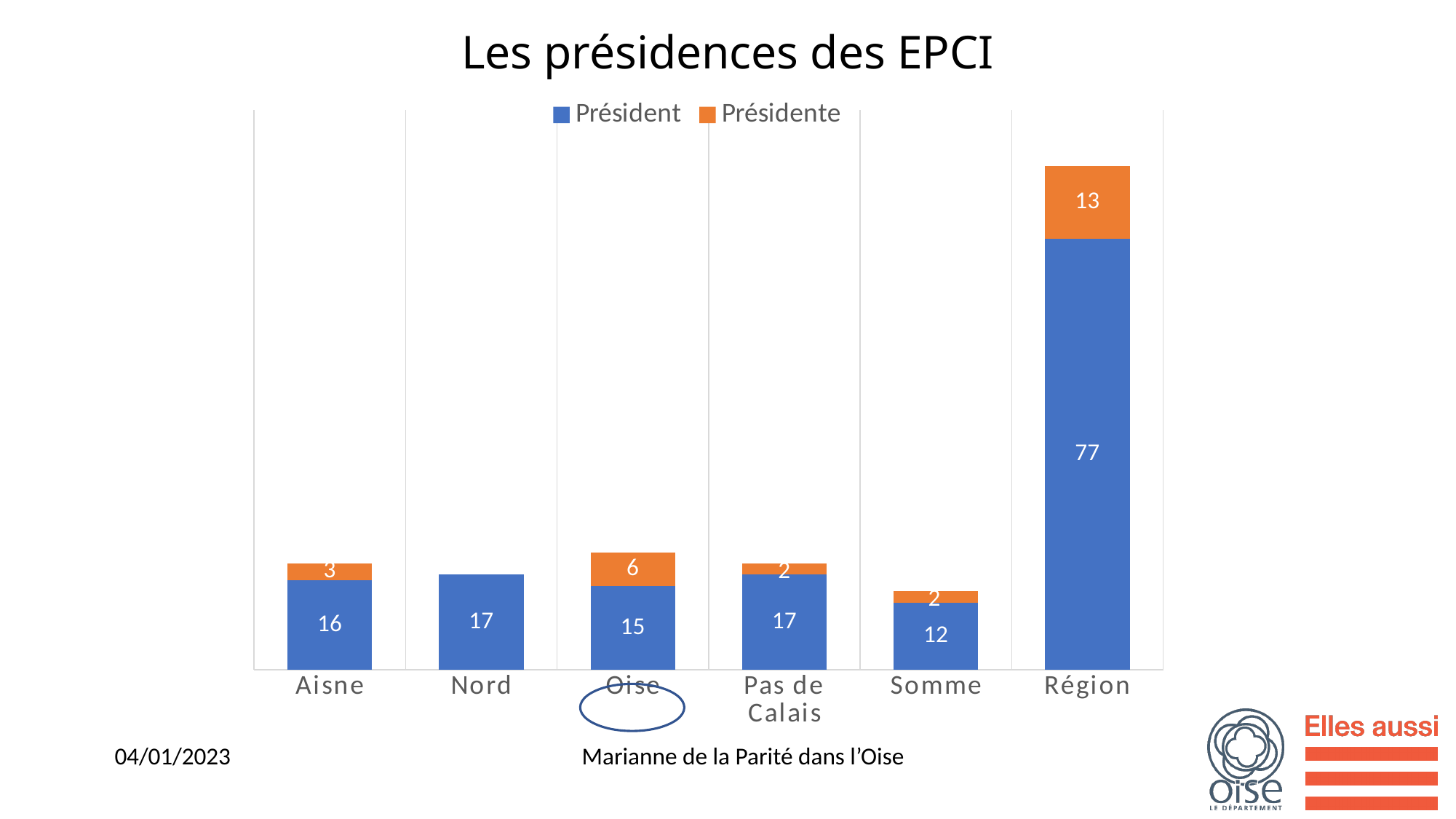
How many categories are shown on the x axis? 6 How many series does the legend list? 2 What type of chart is shown on the slide? Stacked bar chart Which is larger, the Présidente value for Oise or the Présidente value for Aisne? Oise Among the départements (excluding Région), which category has the lowest Président value? Somme What is the Président value for Oise? 15 What is the Présidente value for Aisne? 3 What is the difference between the Président values for Région and Somme? 65 Which category has the highest Président value? Région What is the title of the chart? Les présidences des EPCI What is the total of the stacked bar for Région? 90 What is the Présidente value for Région? 13